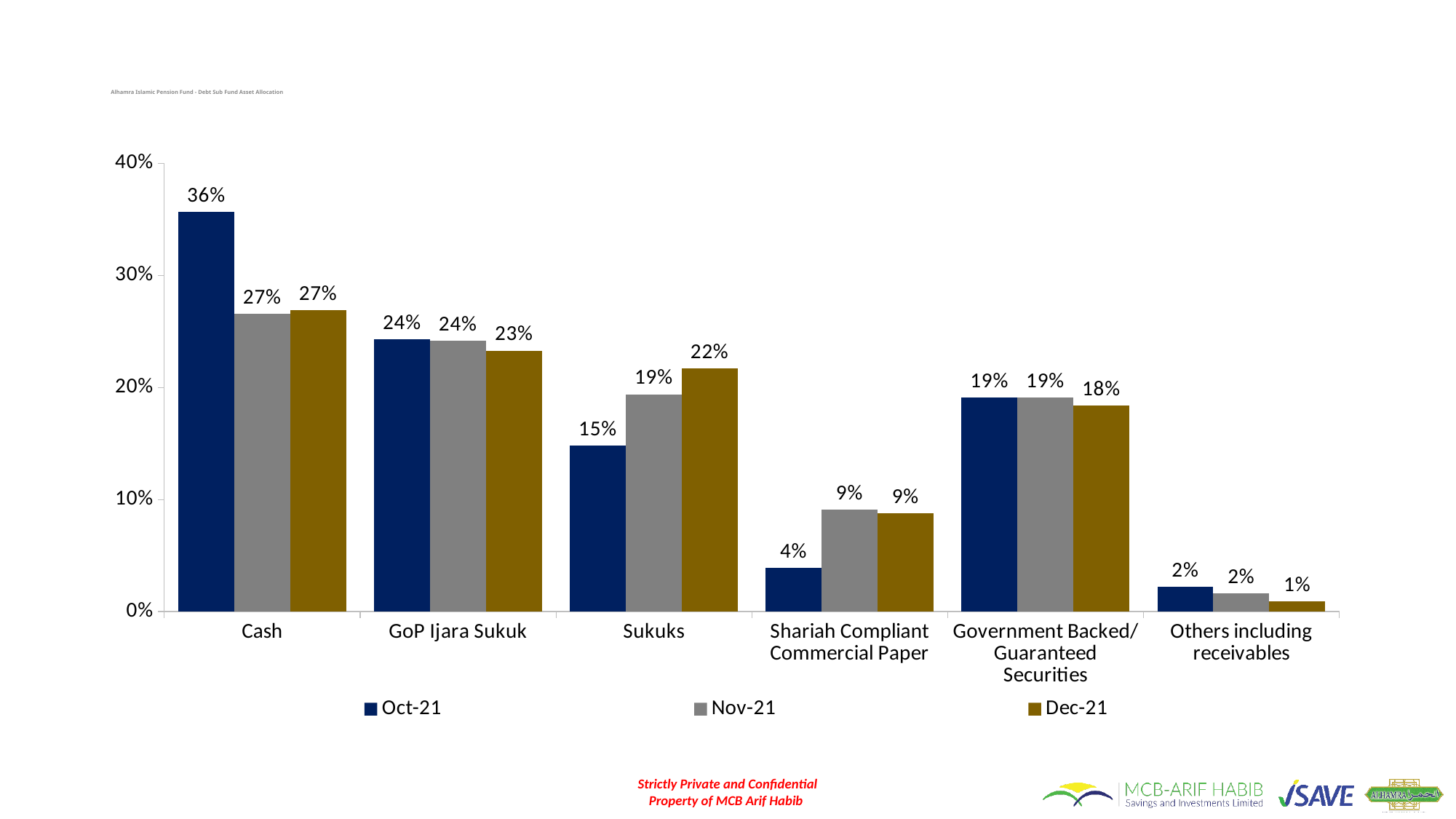
What is the difference between the Oct-21 and Nov-21 values for Cash? 9% Which category has the lowest Dec-21 value? Others including receivables What is the Dec-21 value for Government Backed/ Guaranteed Securities? 18% Which series is shown in gold/brown in the legend? Dec-21 How many categories are shown on the x axis? 6 What is the Nov-21 value for Shariah Compliant Commercial Paper? 9% What is the Dec-21 value for Sukuks? 22% What kind of chart is shown on the slide? Bar chart Which category has the highest Oct-21 value? Cash What is the Oct-21 value for Cash? 36% How many series does the legend list? 3 Which is larger for Sukuks: the Oct-21 value or the Dec-21 value? Dec-21